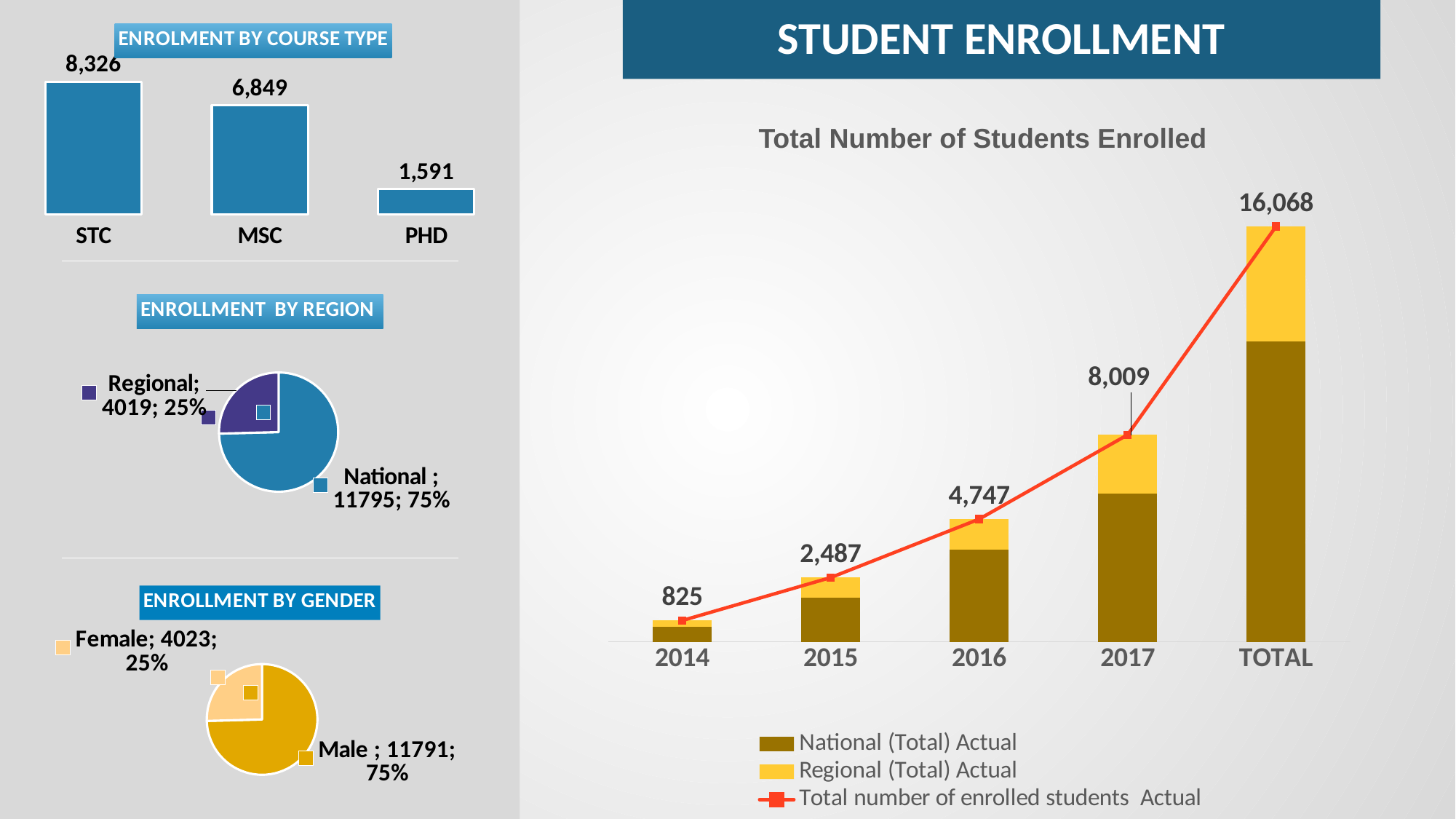
How many series does the legend of the 'Total Number of Students Enrolled' chart list? 3 In the 'Enrollment by Gender' pie chart, what share of enrollment is Female? 25% In the 'Enrolment by Course Type' chart, what is the value for MSC? 6,849 In the 'Enrollment by Region' pie chart, what is the value for Regional? 4019 In the 'Total Number of Students Enrolled' chart, what is the difference between the 2017 and 2015 totals? 5,522 In the 'Total Number of Students Enrolled' chart, do the totals rise or fall from 2014 to 2017? rise In the 'Enrolment by Course Type' chart, which course type has the lowest enrolment? PHD In the 'Enrolment by Course Type' chart, what is the difference between the STC and PHD values? 6,735 In the 'Total Number of Students Enrolled' chart, what is the total number of enrolled students for 2016? 4,747 In the 'Enrollment by Region' pie chart, what share of enrollment is National? 75% In the 'Enrolment by Course Type' chart, which course type has the highest enrolment? STC In the 'Enrollment by Gender' pie chart, what is the value for Male? 11791